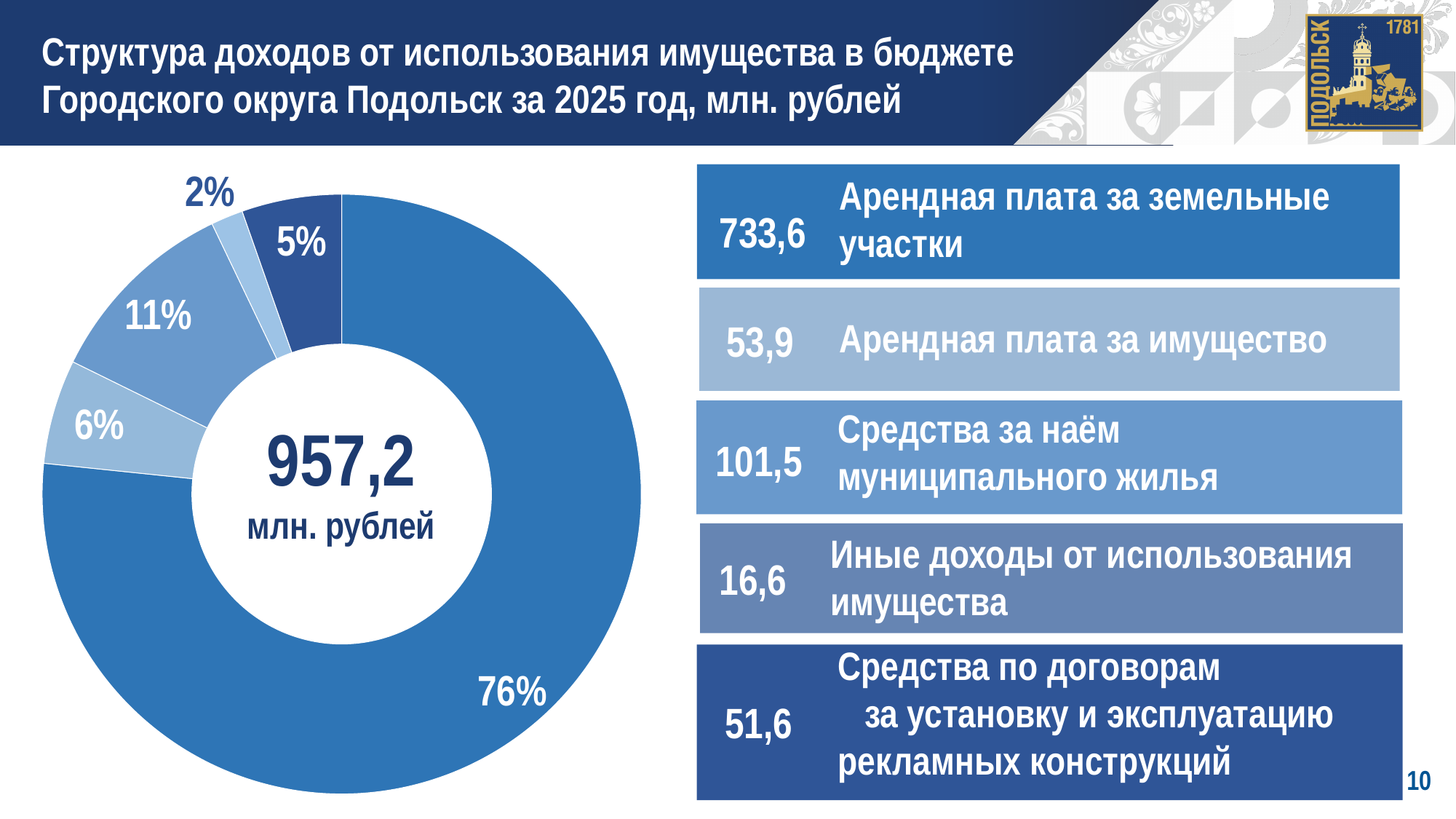
Какое значение указано для категории «Иные доходы от использования имущества»? 16,6 Какую долю (в процентах) занимает арендная плата за земельные участки? 76% Какую долю (в процентах) занимают средства за наём муниципального жилья? 11% Какая категория имеет наибольшую долю в структуре доходов? Арендная плата за земельные участки Какое значение указано для категории «Арендная плата за земельные участки»? 733,6 Сколько категорий доходов показано на диаграмме? 5 Какое значение указано для категории «Средства за наём муниципального жилья»? 101,5 Какой тип диаграммы показан на слайде? Кольцевая (круговая) диаграмма Какая общая сумма доходов от использования имущества указана в центре диаграммы? 957,2 млн. рублей На сколько млн. рублей арендная плата за имущество больше иных доходов от использования имущества? 37,3 Какая категория имеет наименьшую долю в структуре доходов? Иные доходы от использования имущества Что больше: арендная плата за имущество или средства по договорам за установку и эксплуатацию рекламных конструкций? Арендная плата за имущество